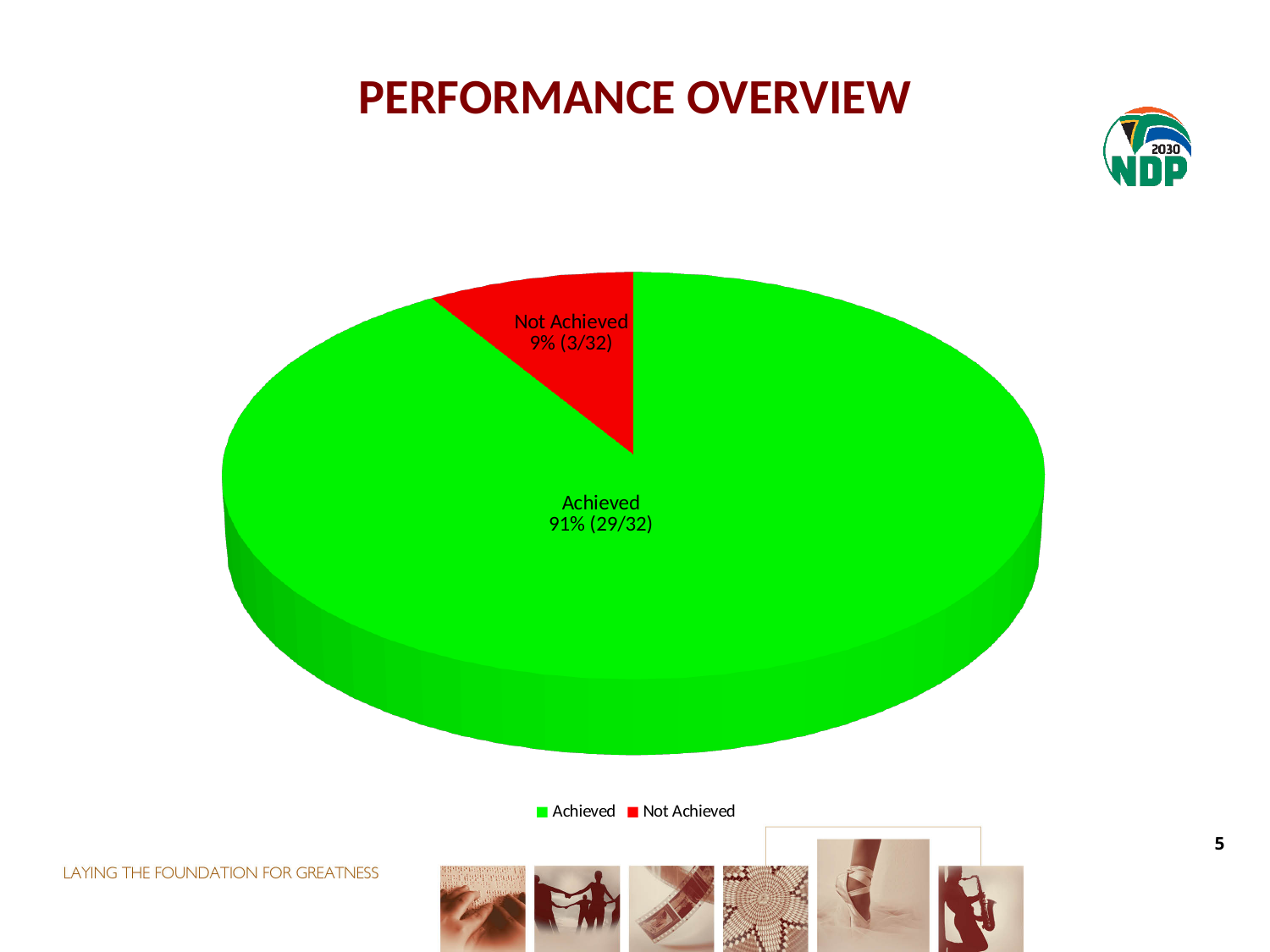
How many targets were achieved, according to the Achieved slice label? 29 What is the total number of targets shown in the slice labels? 32 Which slice is the largest? Achieved Which slice is the smallest? Not Achieved What percentage of the pie is labelled Achieved? 91% What percentage of the pie is labelled Not Achieved? 9% What is the difference in percentage points between the Achieved and Not Achieved slices? 82 How many slices does the pie chart have? 2 What kind of chart is shown on the slide? pie chart What colour is the Not Achieved slice? red How many entries does the legend list? 2 How many targets were not achieved, according to the Not Achieved slice label? 3